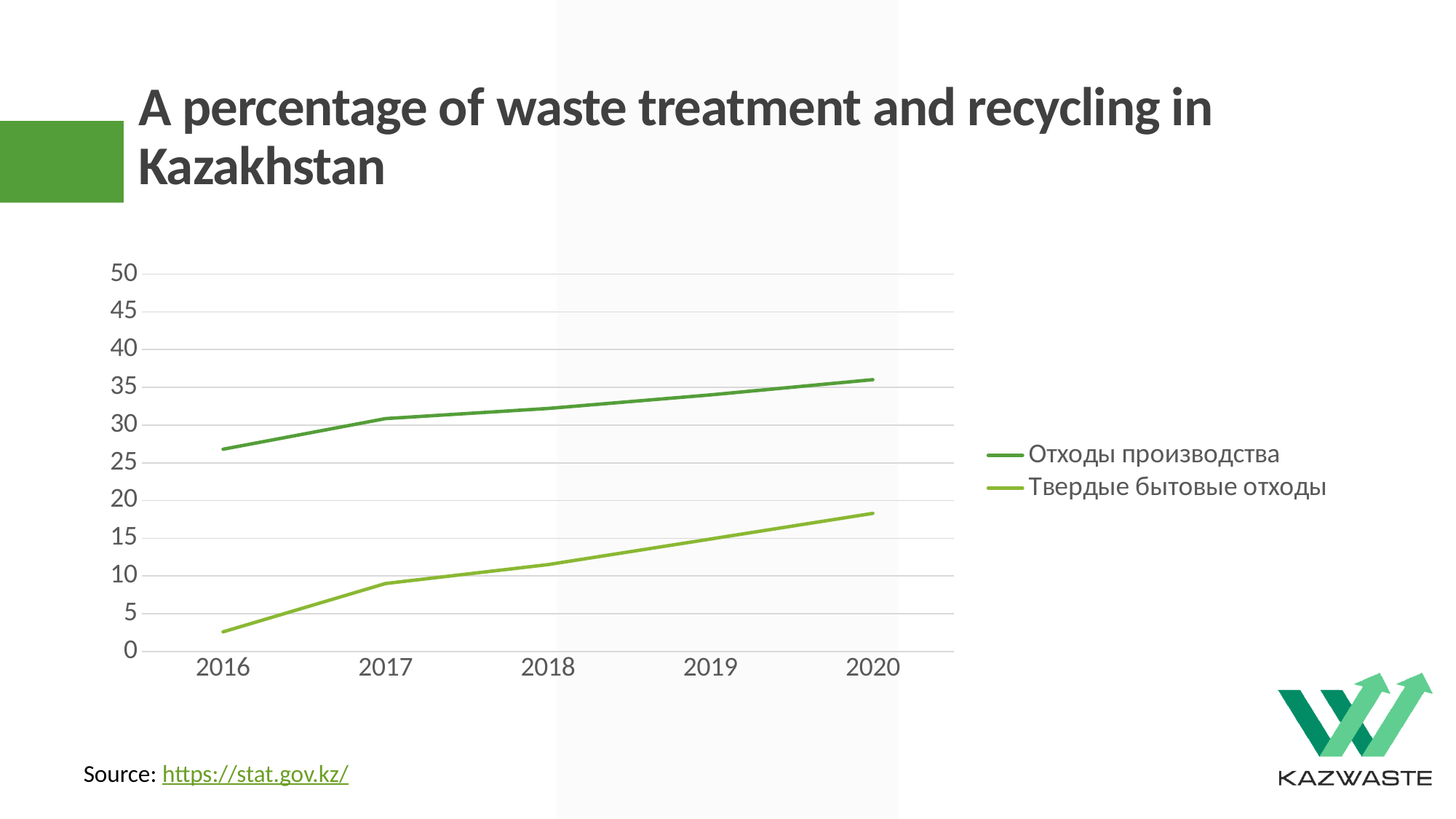
How many years are shown on the x axis? 5 Is the value for Отходы производства in 2020 greater or less than 30? greater In which year is the value for Твердые бытовые отходы lowest? 2016 Is the value for Твердые бытовые отходы in 2020 greater or less than 15? greater Does the value for Отходы производства rise or fall from 2016 to 2020? rise In which year is the value for Отходы производства highest? 2020 How many series does the legend list? 2 What kind of chart is shown on the slide? line chart Does the value for Твердые бытовые отходы rise or fall from 2016 to 2020? rise In 2020, which series has the larger value, Отходы производства or Твердые бытовые отходы? Отходы производства What is the title of the chart on the slide? A percentage of waste treatment and recycling in Kazakhstan Is the value for Твердые бытовые отходы in 2016 greater or less than 5? less